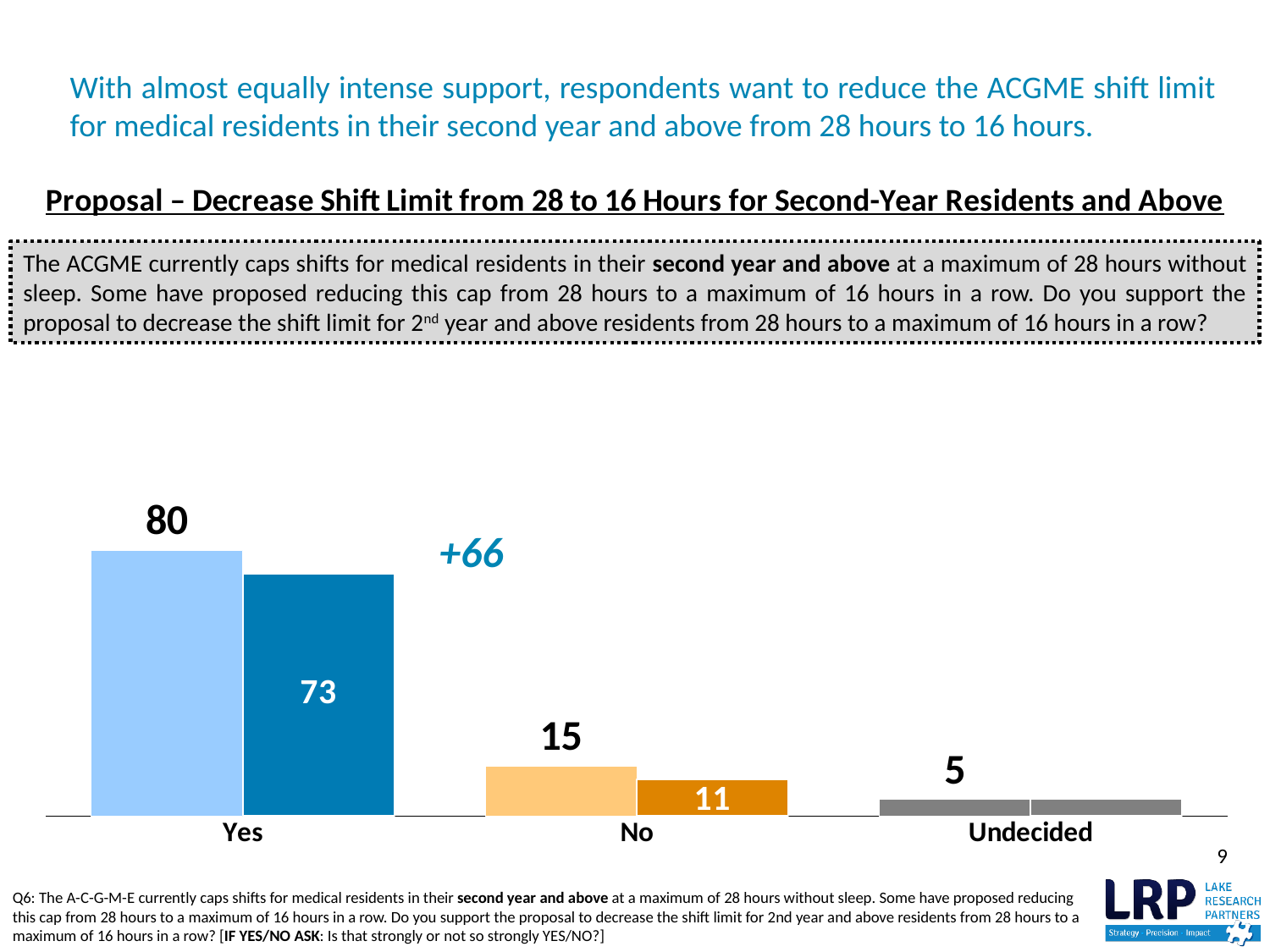
Which is larger, the value for Yes or the value for No? Yes What is the value of the dark orange bar for No? 11 What is the value of the taller (light orange) bar for No? 15 What is the difference between the light blue Yes bar (80) and the dark blue Yes bar (73)? 7 What kind of chart is shown on the slide? Bar chart What is the value of the dark blue bar for Yes? 73 What is the difference between the dark blue Yes bar (73) and the dark orange No bar (11)? 62 How many categories are shown on the x axis? 3 Which category has the lowest value? Undecided What is the value shown for Undecided? 5 What is the value of the taller (light blue) bar for Yes? 80 Which category has the highest value? Yes